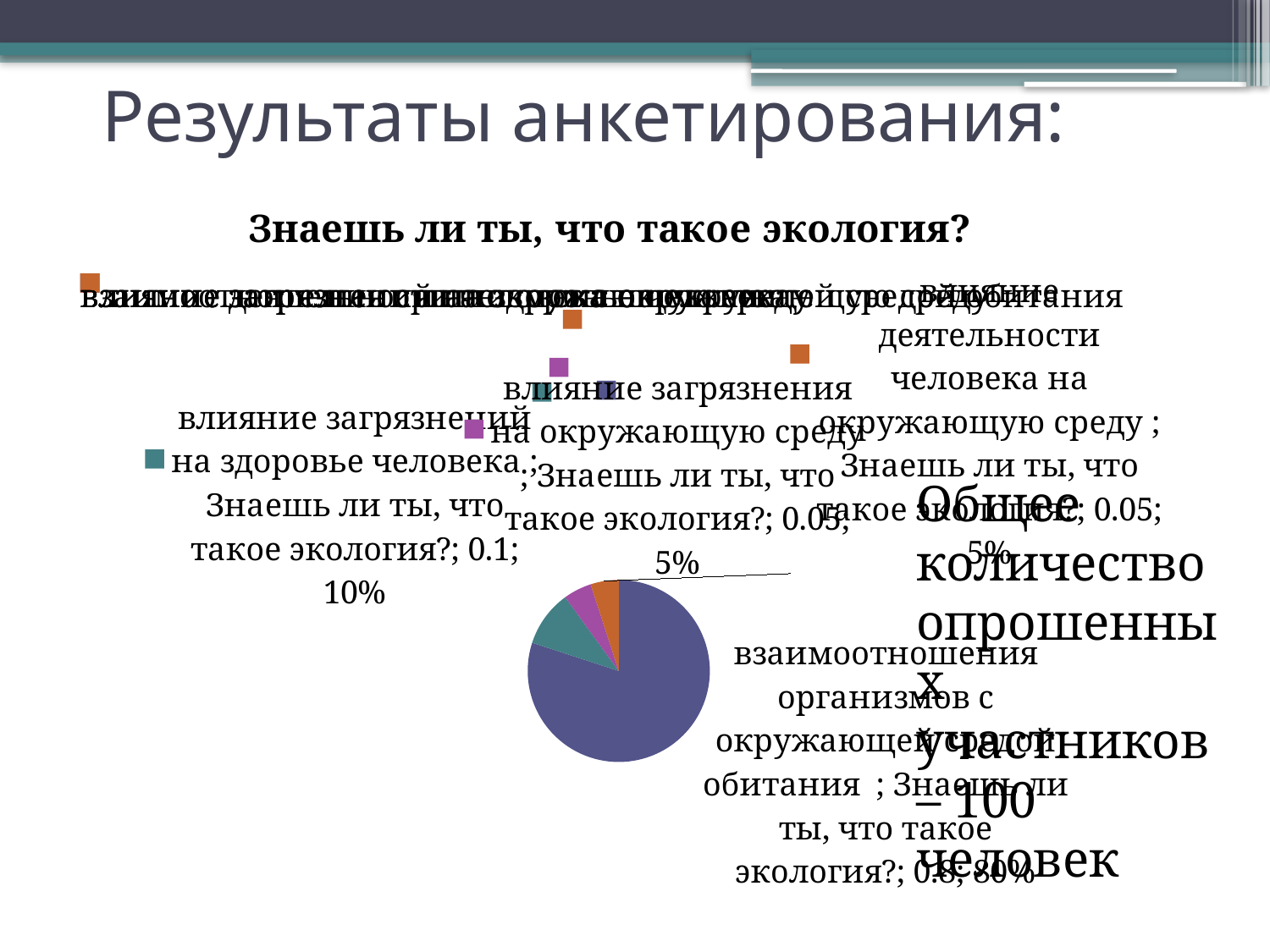
According to the text on the slide, how many participants were surveyed in total? 100 человек What percentage of respondents answered "взаимоотношения организмов с окружающей средой обитания"? 80% What percentage of respondents answered "влияние деятельности человека на окружающую среду"? 5% What is the title of the chart? Знаешь ли ты, что такое экология? What is the difference in percentage points between the "взаимоотношения организмов с окружающей средой обитания" slice and the "влияние загрязнений на здоровье человека" slice? 70 Which is larger: the share for "влияние загрязнений на здоровье человека" or the share for "влияние загрязнения на окружающую среду"? влияние загрязнений на здоровье человека How many slices does the pie chart have? 4 What percentage of respondents answered "влияние загрязнений на здоровье человека"? 10% Is the share for "взаимоотношения организмов с окружающей средой обитания" greater or less than 50%? greater What percentage of respondents answered "влияние загрязнения на окружающую среду"? 5% What kind of chart is shown on the slide? pie chart Which answer has the largest share of the pie? взаимоотношения организмов с окружающей средой обитания